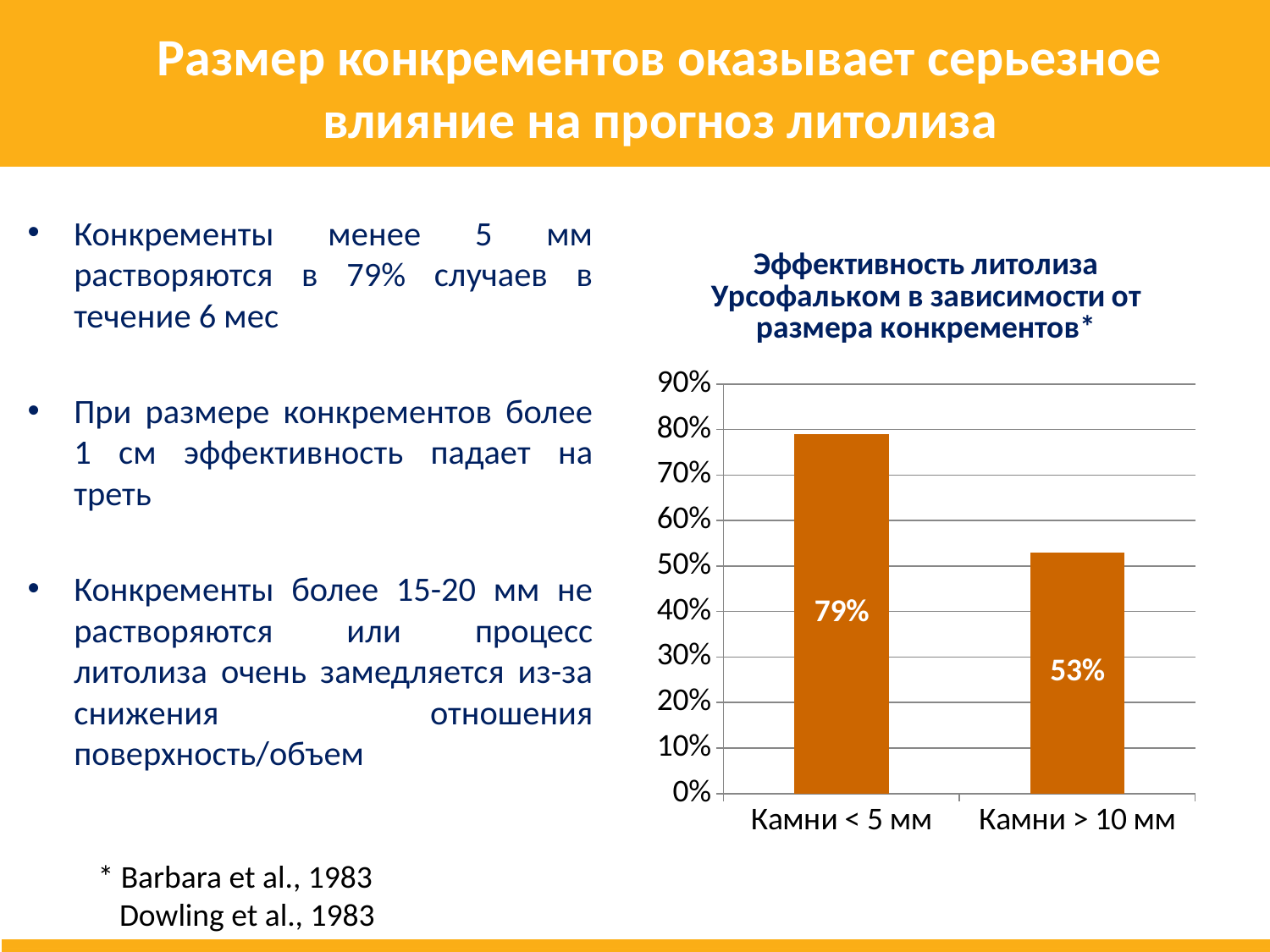
What is the title of the chart? Эффективность литолиза Урсофальком в зависимости от размера конкрементов* What kind of chart is shown on the slide? bar chart Which category has the highest value? Камни < 5 мм How many categories are shown on the x axis? 2 Which is larger, the value for Камни < 5 мм or the value for Камни > 10 мм? Камни < 5 мм What is the difference between the values for Камни < 5 мм and Камни > 10 мм? 26% Do the values rise or fall from left to right along the x axis? fall Is the value for Камни > 10 мм greater or less than 60%? less What is the value for Камни > 10 мм? 53% What is the value for Камни < 5 мм? 79% Is the value for Камни < 5 мм greater or less than 70%? greater Which category has the lowest value? Камни > 10 мм